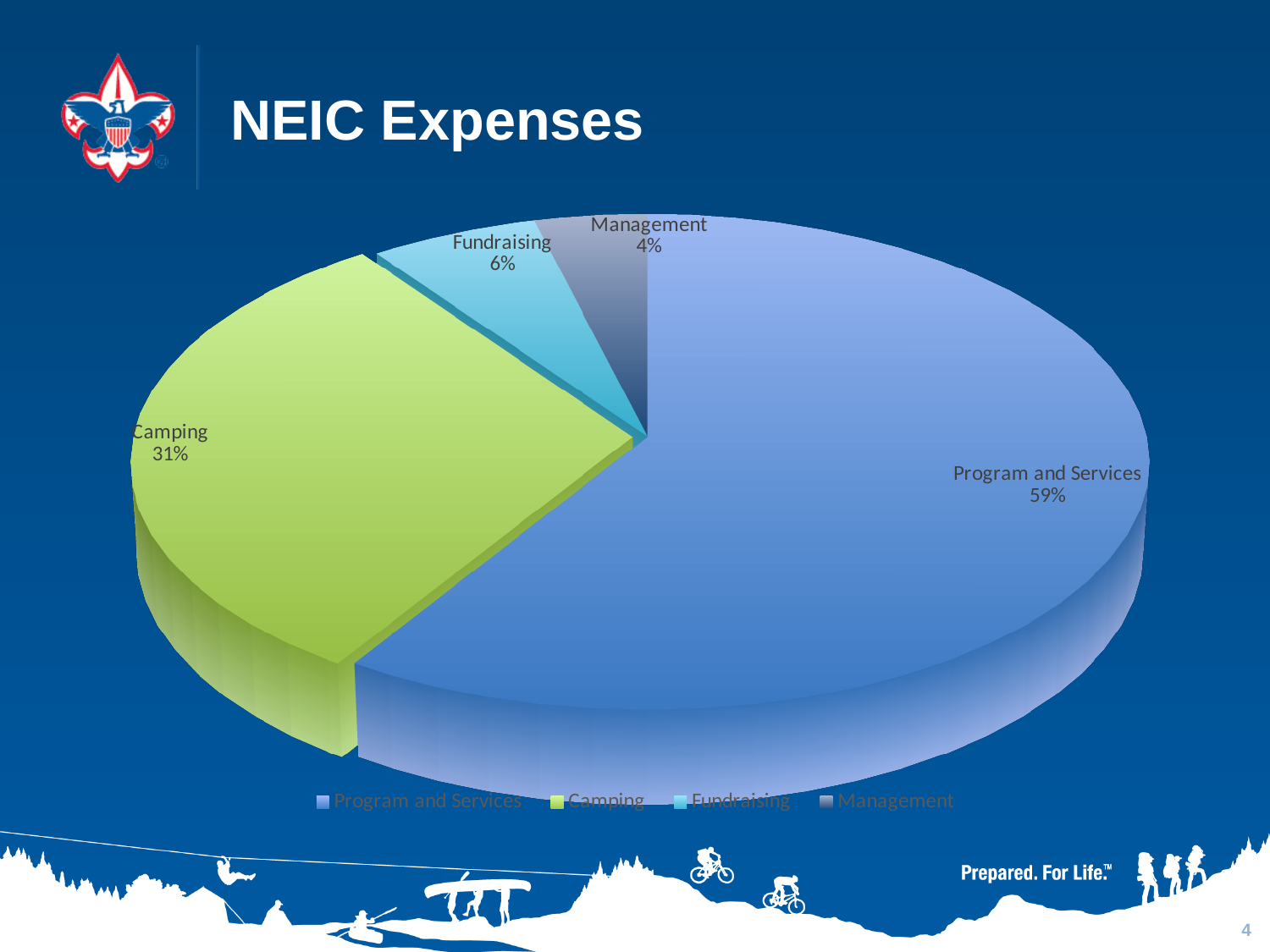
Which expense category has the smallest share? Management What percentage of the pie is Camping? 31% How many categories are shown in the pie chart? 4 What type of chart is shown on the slide? Pie chart What colour is the Camping slice? Green What is the difference in percentage points between Program and Services and Camping? 28 What is the title of the slide? NEIC Expenses What share of NEIC expenses goes to Program and Services? 59% What percentage of expenses is Management? 4% Which expense category has the largest share? Program and Services Which is larger, the Fundraising share or the Management share? Fundraising What share of expenses is Fundraising? 6%